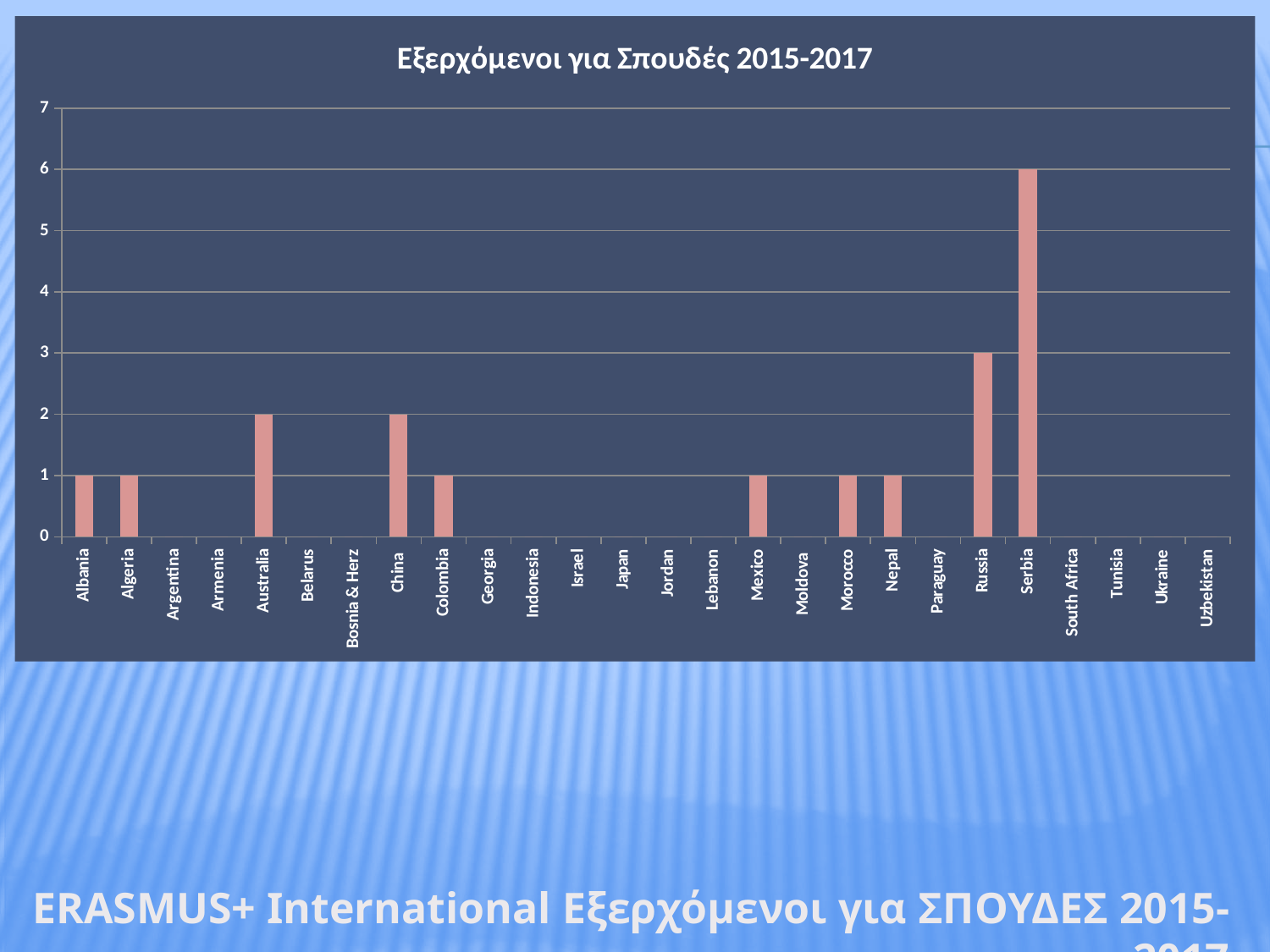
What is the value for Russia? 3 Which country has the highest value in the chart? Serbia Is the value for Serbia greater or less than 5? greater What is the value for Australia? 2 Which is larger, the value for Russia or the value for China? Russia What is the difference between the values for Serbia and Russia? 3 What is the title of the chart? Εξερχόμενοι για Σπουδές 2015-2017 What is the value for Serbia? 6 What is the value for China? 2 What is the value for Albania? 1 What kind of chart is shown on the slide? Bar chart How many countries are listed on the x axis of the chart? 26